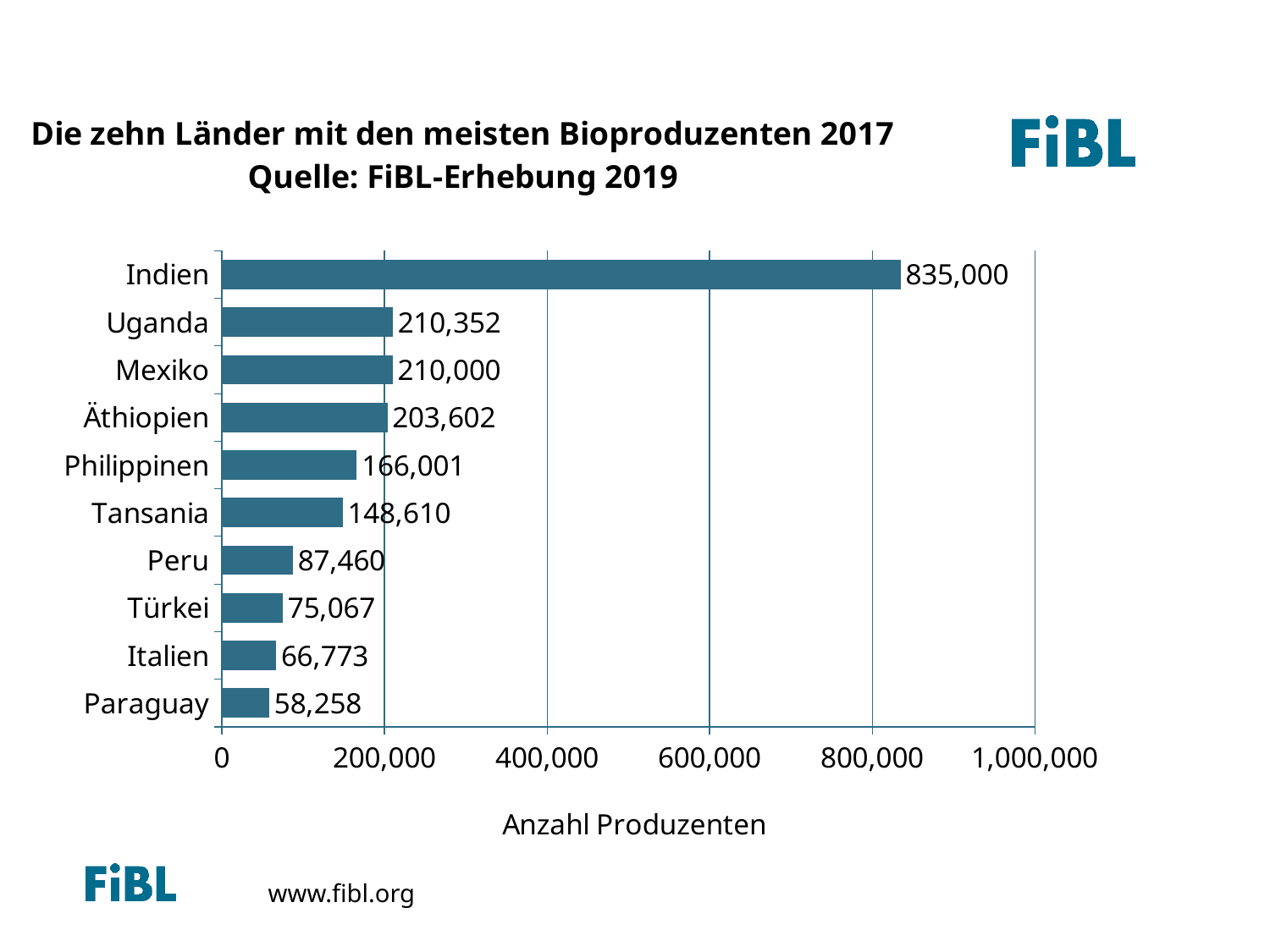
Which has more producers, Philippinen or Tansania? Philippinen Is the value for Äthiopien greater or less than 200,000? greater What is the value shown for Türkei? 75,067 What is the label of the horizontal axis? Anzahl Produzenten Which country has the lowest number of producers? Paraguay Which country has the highest number of producers? Indien What is the value shown for Tansania? 148,610 How many countries are shown in the chart? 10 How many producers does Indien have according to the chart? 835,000 What is the difference between the values for Peru and Italien? 20,687 What kind of chart is shown on the slide? bar chart What is the difference between the values for Indien and Uganda? 624,648